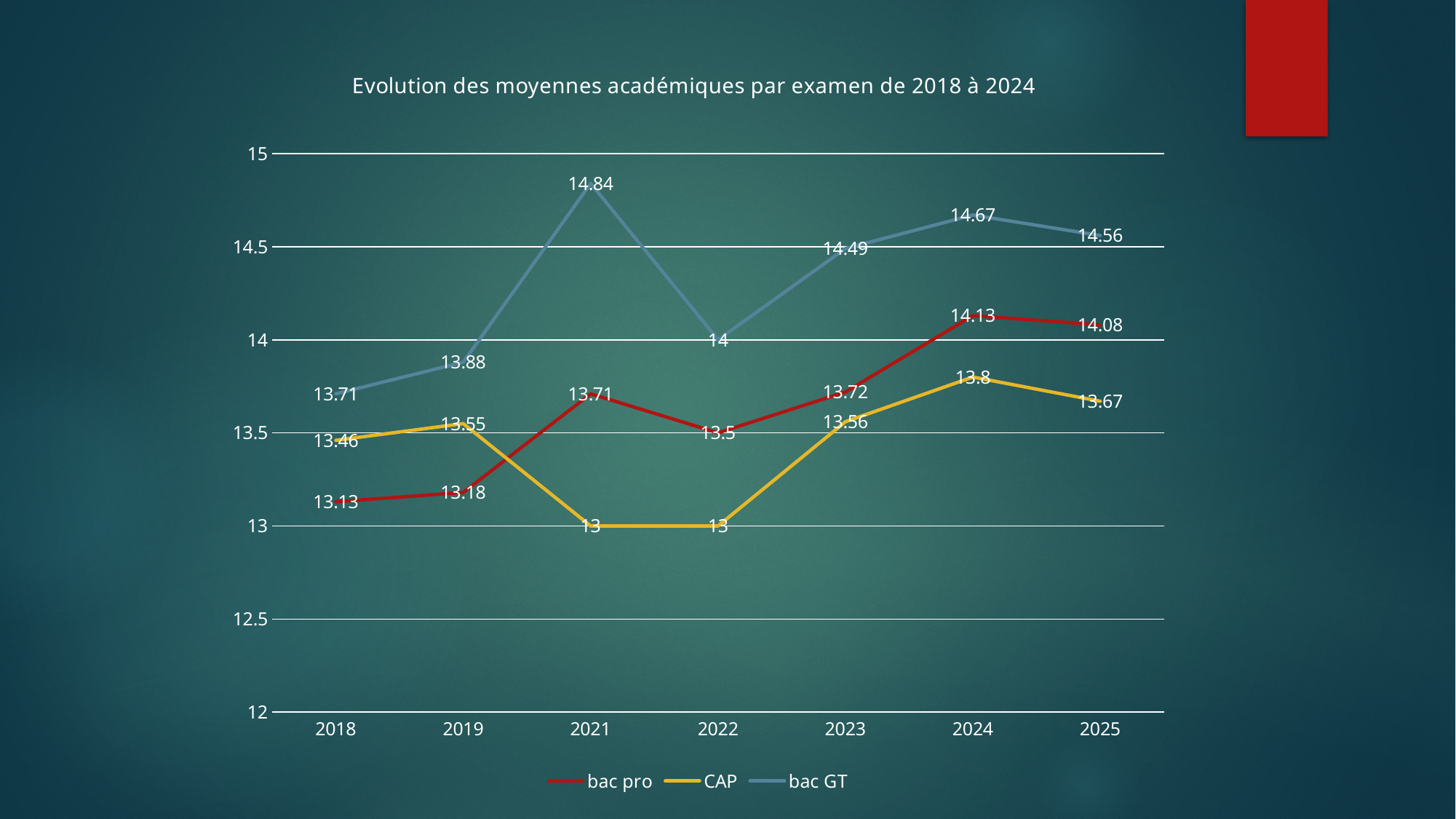
How many years are plotted along the x axis? 7 In which year is the bac GT value highest? 2021 In which year is the bac pro value lowest? 2018 Which is larger in 2019, the CAP value or the bac pro value? CAP Does the bac pro series rise or fall from 2018 to 2024? rise What is the difference between the bac GT and bac pro values in 2025? 0.48 What is the value for bac pro in 2024? 14.13 How many series does the legend list? 3 What is the value for CAP in 2022? 13 What type of chart is shown on the slide? line chart What is the title of the chart? Evolution des moyennes académiques par examen de 2018 à 2024 What is the value for bac GT in 2021? 14.84